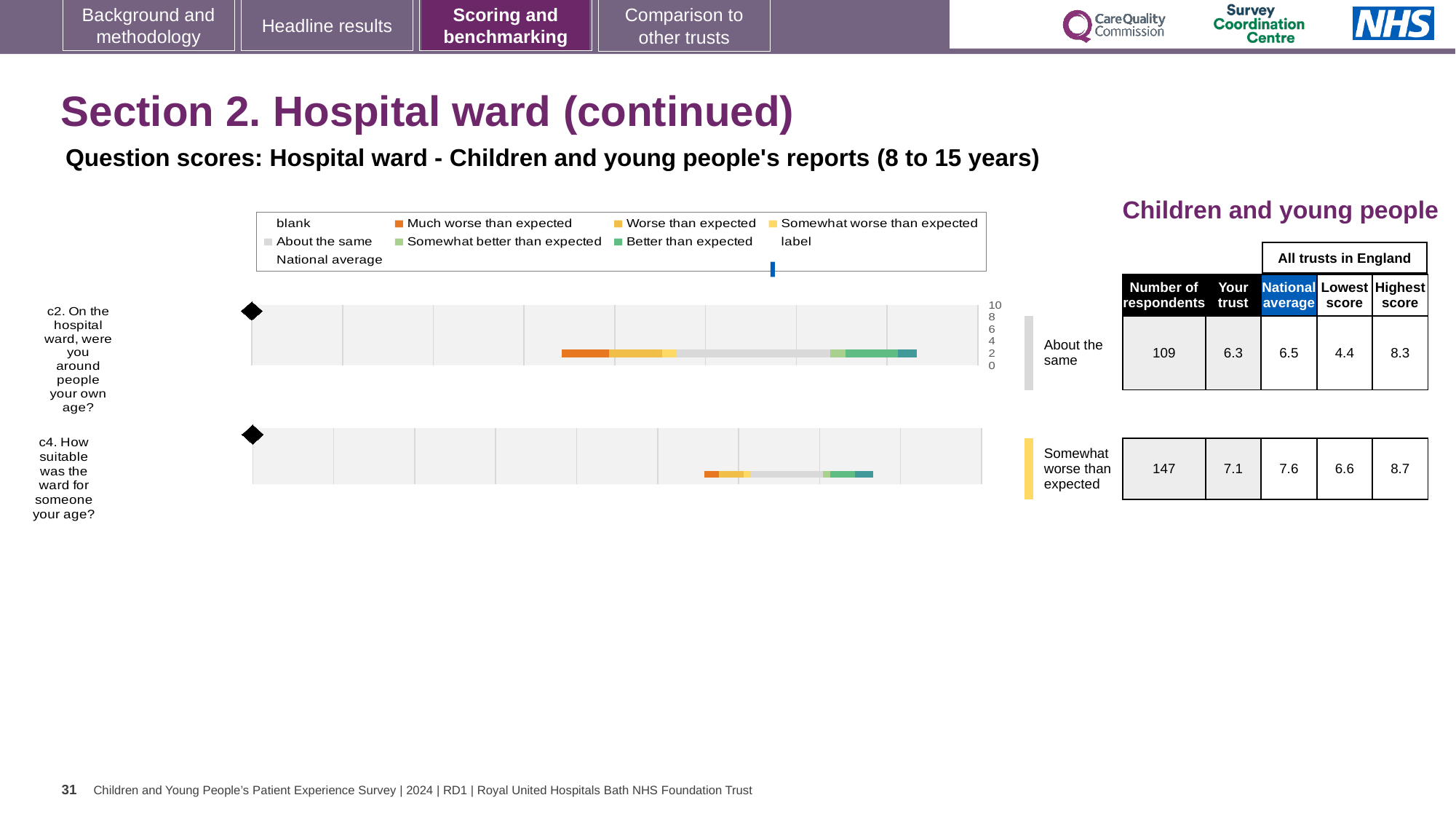
What is the 'Your trust' score for question c2 (On the hospital ward, were you around people your own age?)? 6.3 How many respondents answered question c4? 147 How many questions (c2 and c4) are plotted on the slide? 2 What is the highest score among all trusts in England for question c4? 8.7 What is the difference between the highest and lowest scores for question c4? 2.1 What is the lowest score among all trusts in England for question c2? 4.4 What is the national average score for question c2? 6.5 Which question has the higher 'Your trust' score, c2 or c4? c4 What benchmark category is shown for question c2? About the same What benchmark category is shown for question c4? Somewhat worse than expected What is the 'Your trust' score for question c4 (How suitable was the ward for someone your age?)? 7.1 What kind of chart is used to show the question scores for c2 and c4? bar chart